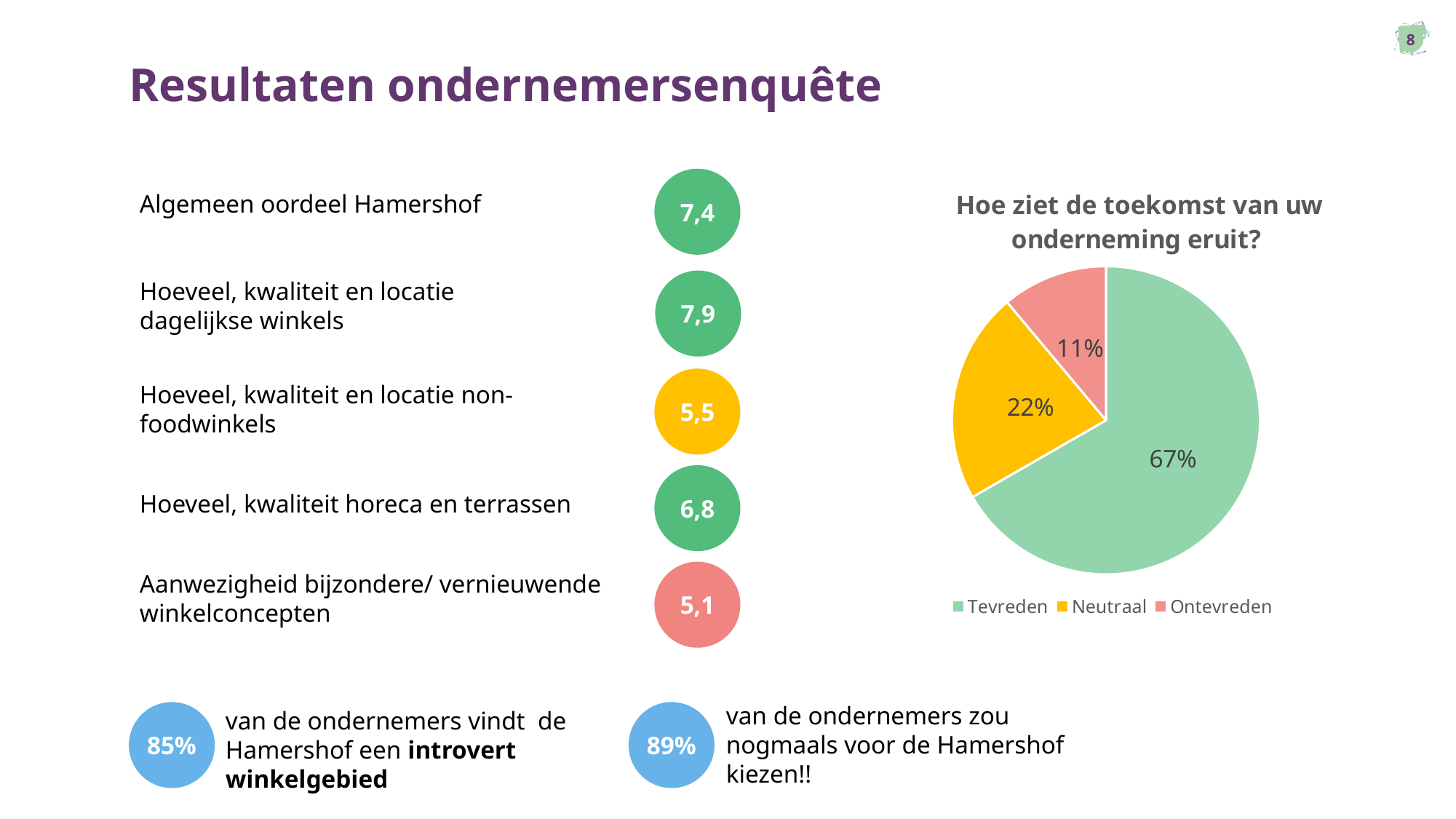
How many slices does the pie chart have? 3 Which category has the smallest slice in the pie chart? Ontevreden What kind of chart is shown on the slide? pie chart What share of the pie chart is Tevreden? 67% What share of the pie chart is Ontevreden? 11% How many entries does the legend of the pie chart list? 3 What is the difference in percentage points between the Tevreden and Neutraal slices? 45 Which slice is larger in the pie chart, Neutraal or Ontevreden? Neutraal What is the title of the pie chart? Hoe ziet de toekomst van uw onderneming eruit? What share of the pie chart is Neutraal? 22% Which category has the largest slice in the pie chart? Tevreden What colour is the Neutraal slice in the pie chart? yellow